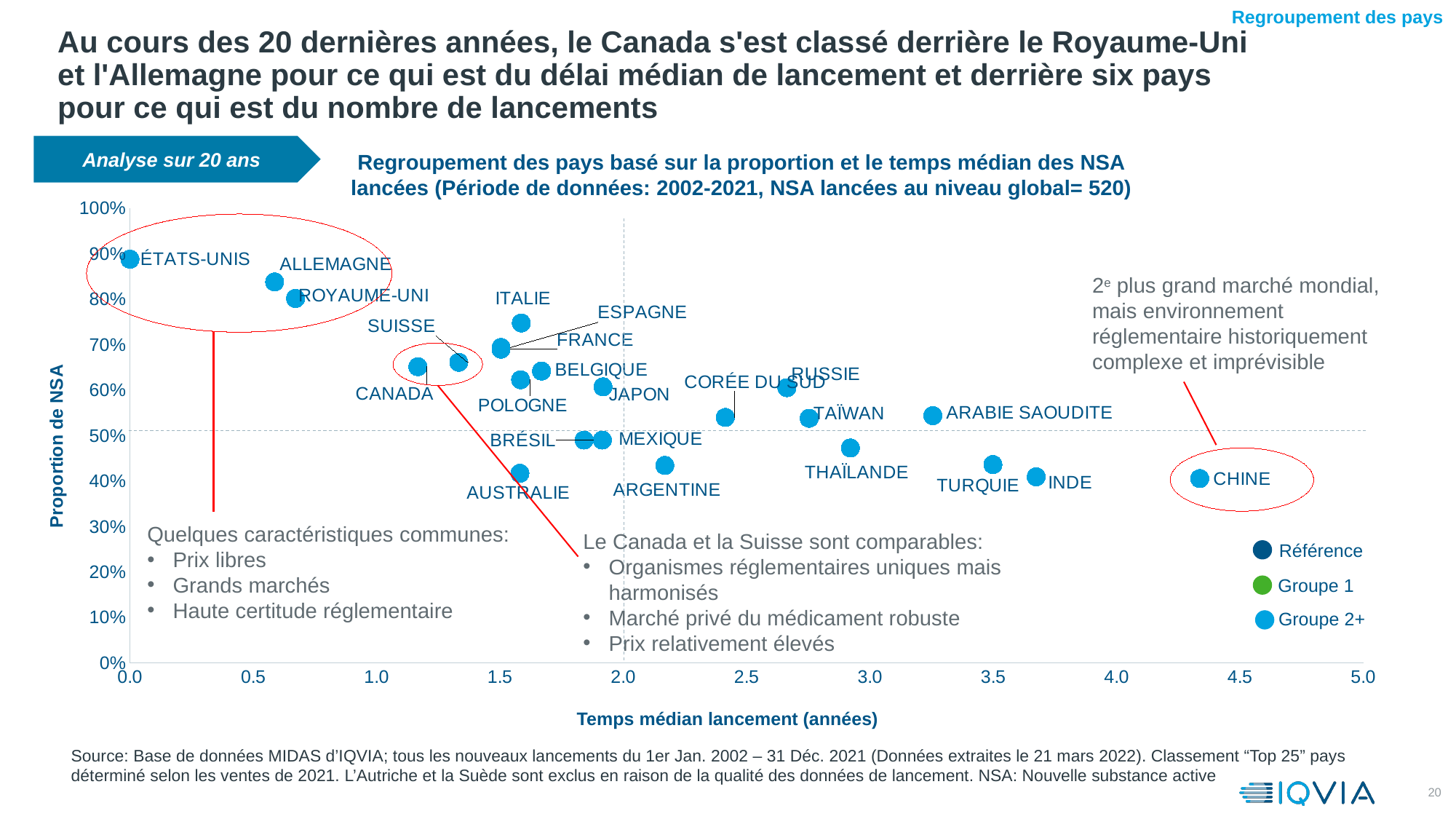
What kind of chart is shown on the slide? Scatter chart Is the proportion of NSA for AUSTRALIE greater or less than 50%? less Which country has the longest median launch time (Temps médian lancement)? CHINE Which has a higher proportion of NSA, ALLEMAGNE or ROYAUME-UNI? ALLEMAGNE How many entries does the legend list? 3 Which has a longer median launch time, CANADA or CHINE? CHINE How many countries are plotted on the chart? 23 What is the title of the x axis of the chart? Temps médian lancement (années) Which country has the highest proportion of NSA (Proportion de NSA)? ÉTATS-UNIS Is the median launch time for CHINE greater or less than 4.0 years? greater Which country has the shortest median launch time (Temps médian lancement)? ÉTATS-UNIS Is the proportion of NSA for ITALIE greater or less than 70%? greater